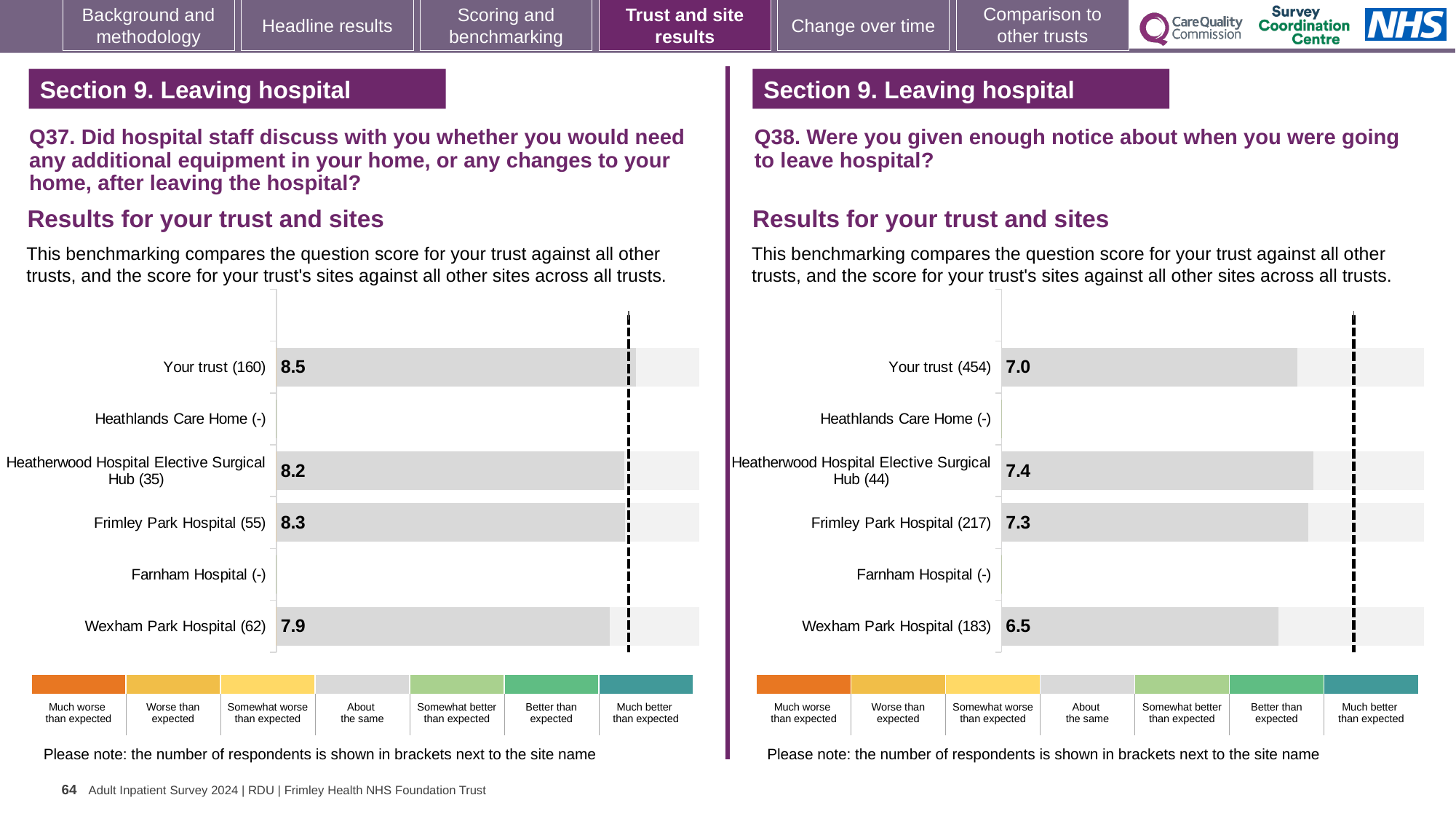
In the Q37 chart on the left, what is the difference between the scores for Frimley Park Hospital and Heatherwood Hospital Elective Surgical Hub? 0.1 In the Q38 chart on the right, which site has the highest score? Heatherwood Hospital Elective Surgical Hub In the Q37 chart on the left, what is the score for Your trust? 8.5 In the Q38 chart on the right, what is the score for Wexham Park Hospital? 6.5 How many rows (trust and sites) are listed in the Q37 chart on the left? 6 In the Q37 chart on the left, how many respondents are shown for Your trust? 160 In the Q38 chart on the right, what is the score for Heatherwood Hospital Elective Surgical Hub? 7.4 In the Q38 chart on the right, which is larger: the score for Frimley Park Hospital or the score for Wexham Park Hospital? Frimley Park Hospital In the Q37 chart on the left, which site has the lowest score? Wexham Park Hospital In the Q37 chart on the left, what is the score for Wexham Park Hospital? 7.9 In the Q38 chart on the right, what is the difference between the scores for Your trust and Wexham Park Hospital? 0.5 What kind of chart is used for the Q38 results on the right? Bar chart